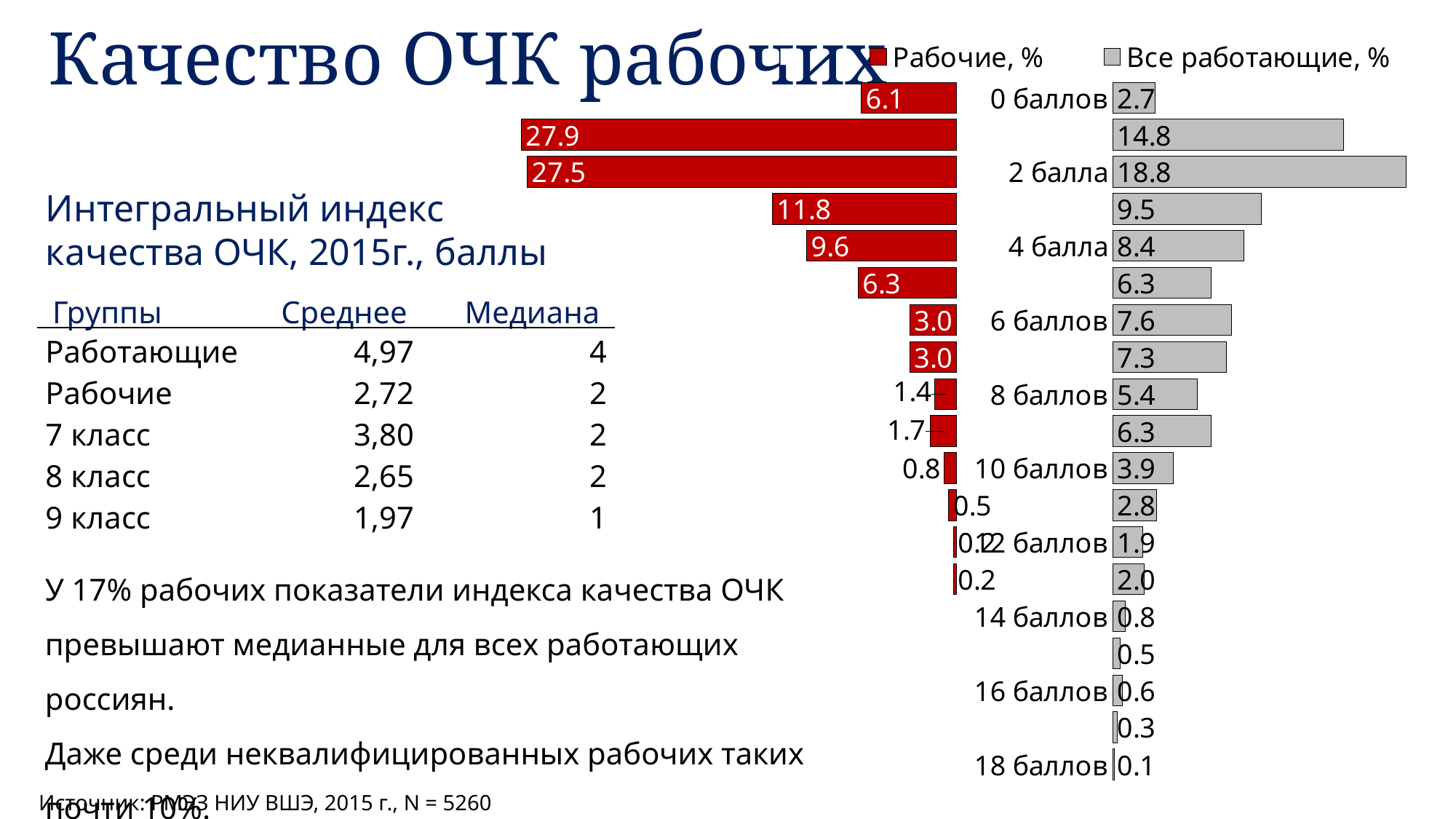
What is the value for Рабочие, % at 0 баллов? 6.1 What is the value for Рабочие, % at 4 балла? 9.6 What is the value for Все работающие, % at 2 балла? 18.8 Which labelled category has the highest value for Все работающие, %? 2 балла What is the difference between Рабочие, % and Все работающие, % at 2 балла? 8.7 What is the value for Все работающие, % at 18 баллов? 0.1 At 6 баллов, which series has the larger value: Рабочие, % or Все работающие, %? Все работающие, % How many series does the chart legend list? 2 What is the value for Все работающие, % at 8 баллов? 5.4 What kind of chart is shown on the slide? bar chart What is the value for Все работающие, % at 6 баллов? 7.6 What colour are the bars for the series Рабочие, %? red